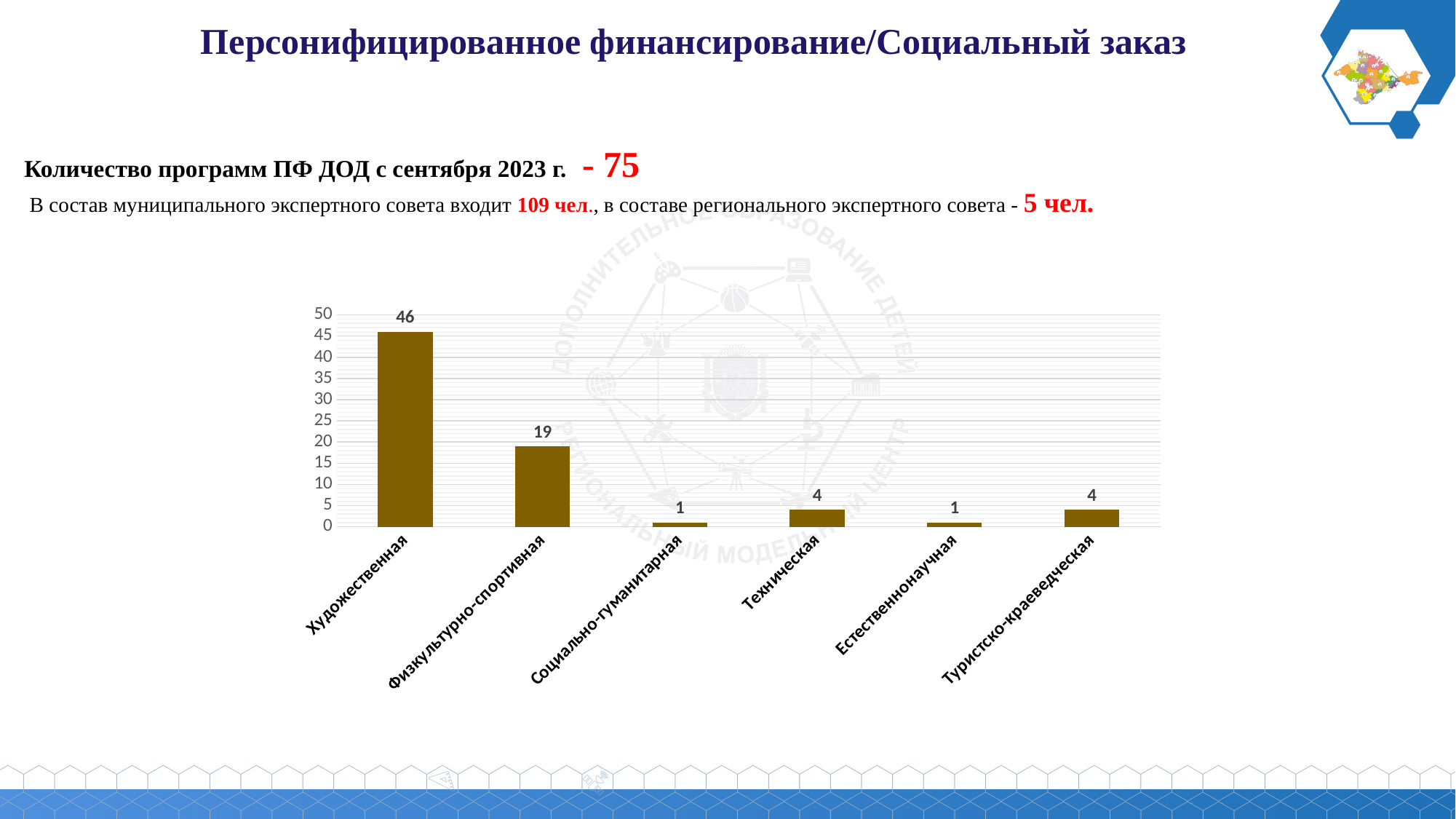
How many categories are shown on the chart? 6 What is the value for Художественная? 46 What is the difference between the values for Художественная and Физкультурно-спортивная? 27 What kind of chart is shown on the slide? bar chart Is the value for Физкультурно-спортивная greater or less than 25? less What is the maximum value shown on the vertical axis of the chart? 50 Which is larger, the value for Техническая or the value for Социально-гуманитарная? Техническая What is the value for Техническая? 4 Which category has the highest value? Художественная What is the difference between the values for Туристско-краеведческая and Естественнонаучная? 3 What is the value for Физкультурно-спортивная? 19 What is the value for Естественнонаучная? 1